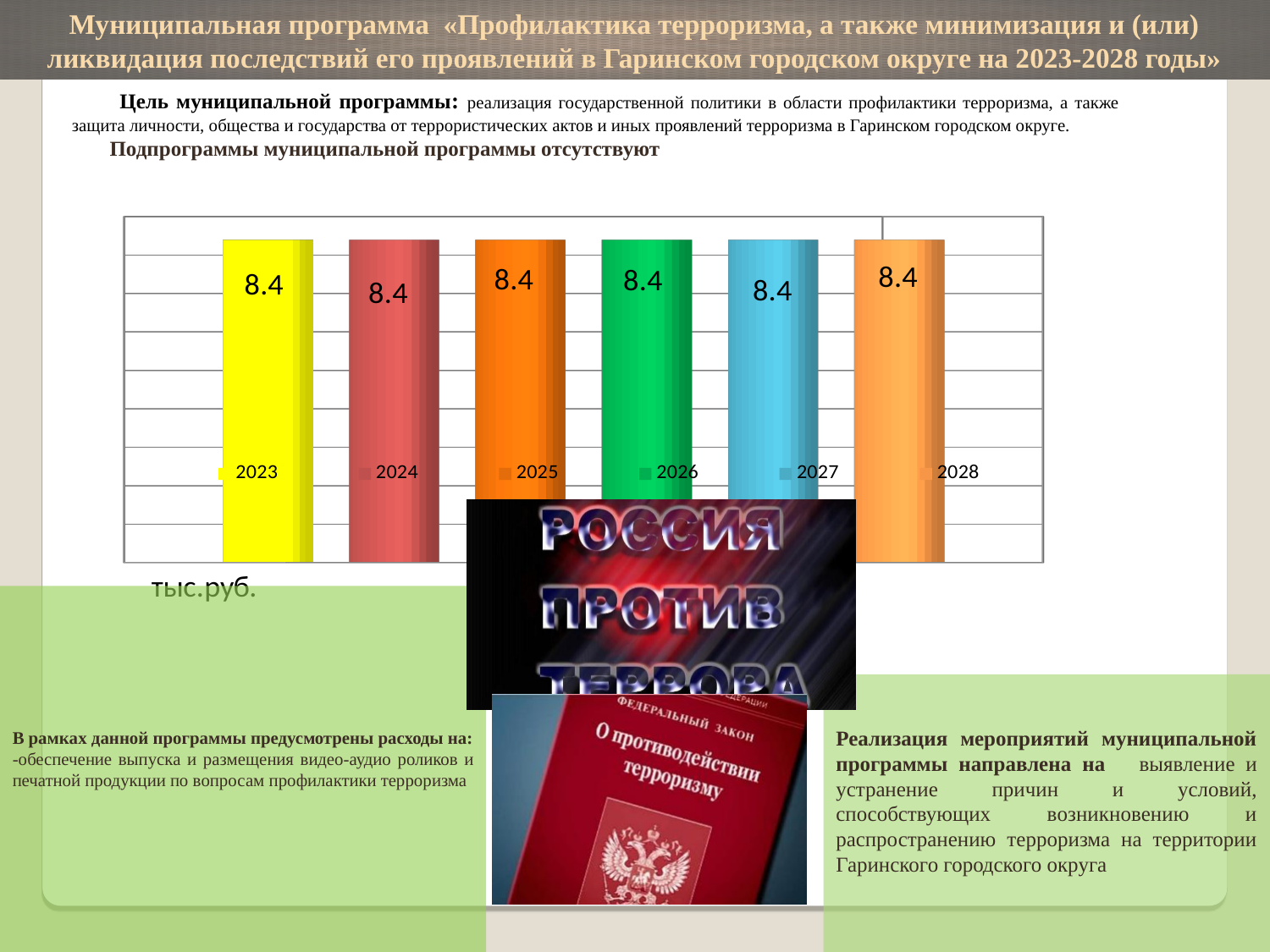
What is the value of the bar for 2026? 8.4 What unit is written below the chart? тыс.руб. What is the value of the bar for 2025? 8.4 What colour is the bar for 2023? yellow What is the value of the bar for 2028? 8.4 How many bars are shown in the chart? 6 What is the difference between the values for 2024 and 2027? 0 What is the value of the bar for 2023? 8.4 What kind of chart is shown on the slide? bar chart What is the total of the values for 2023 and 2024? 16.8 Do the values rise, fall, or stay the same from 2023 to 2028? stay the same How many entries does the chart's legend list? 6